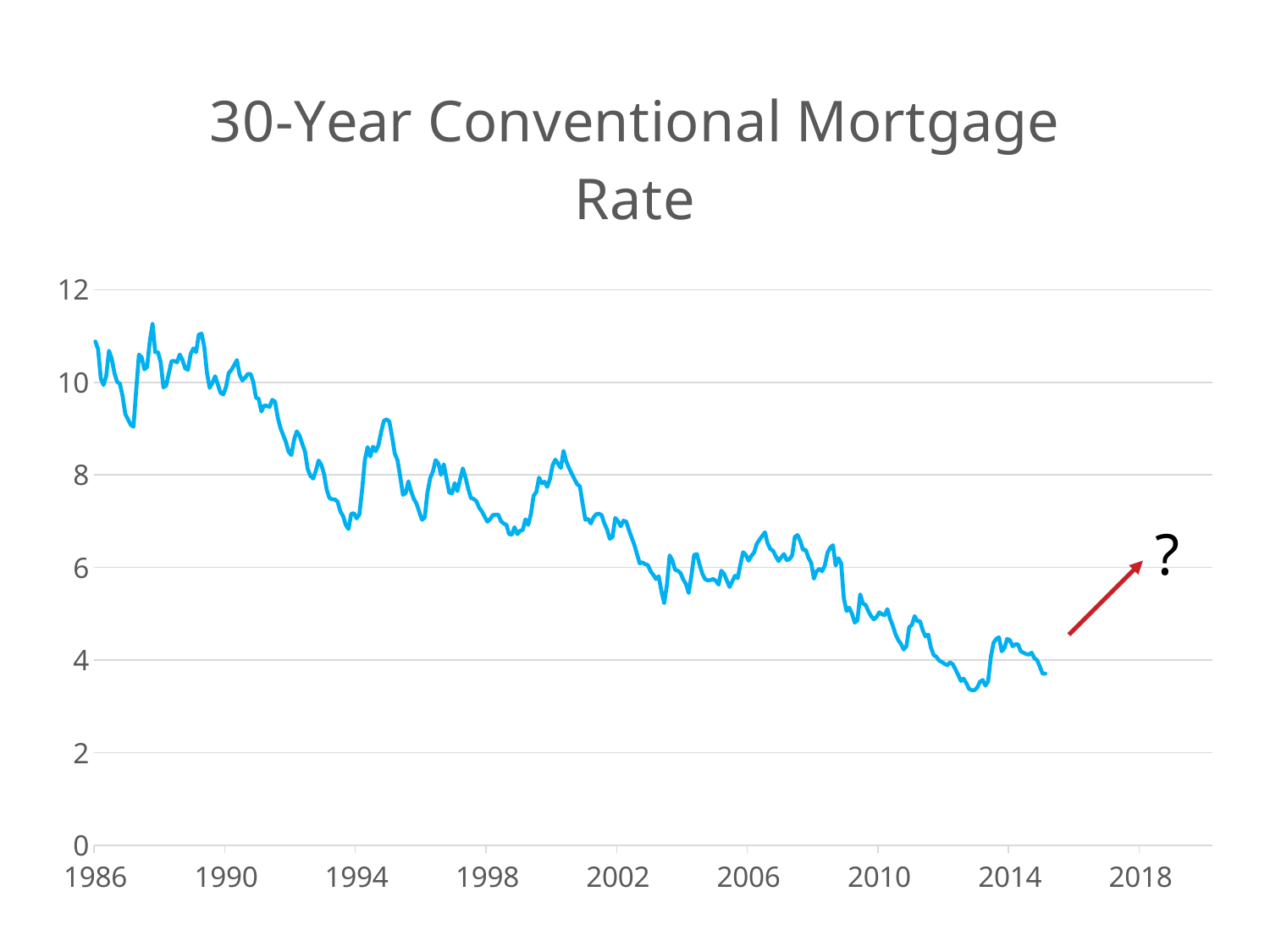
Is the mortgage rate in 2006 greater or less than 6? greater Is the mortgage rate at the start of 1986 greater or less than 10? greater Is the mortgage rate in 2010 greater or less than 6? less Which is higher, the mortgage rate in 1994 or in 2002? 1994 How many data series are plotted on the chart? 1 Overall, does the mortgage rate rise or fall from 1986 to 2014? fall What kind of chart is shown on the slide? line chart Which is higher, the mortgage rate in 1986 or in 2014? 1986 What is the title of the chart? 30-Year Conventional Mortgage Rate What is the highest value shown on the vertical axis? 12